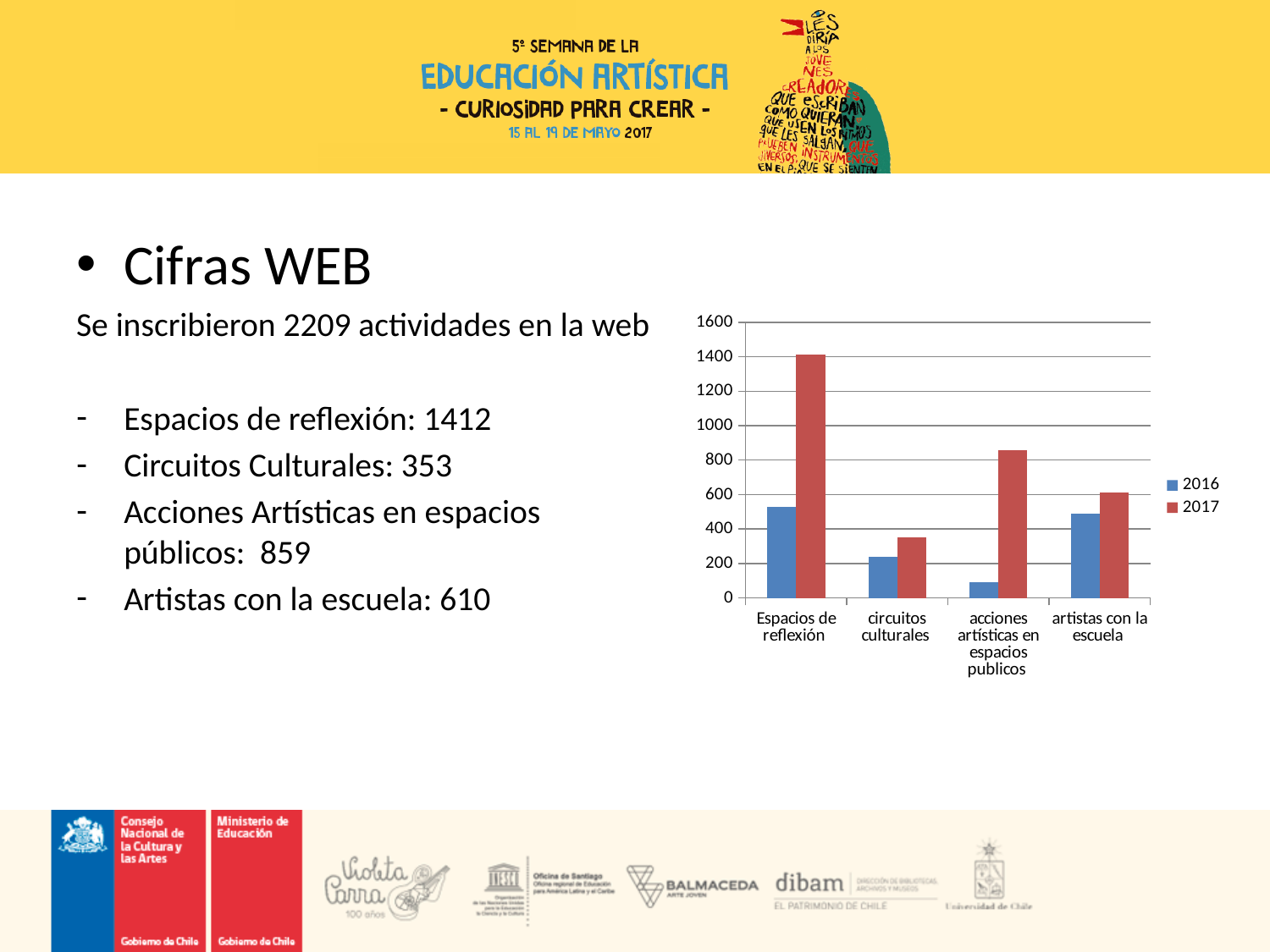
Which category has the highest value for 2017? Espacios de reflexión What colour represents the 2017 series in the chart? red What kind of chart is shown on the slide? bar chart For 2017, which is larger: acciones artísticas en espacios publicos or artistas con la escuela? acciones artísticas en espacios publicos Which category has the lowest value for 2016? acciones artísticas en espacios publicos Is the 2017 value for Espacios de reflexión greater or less than 1200? greater How many series does the chart legend list? 2 How many categories are shown on the x axis of the chart? 4 Is the 2016 value for acciones artísticas en espacios publicos greater or less than 200? less Is the 2017 value for artistas con la escuela greater or less than 400? greater For circuitos culturales, which year has the larger value, 2016 or 2017? 2017 Which category has the lowest value for 2017? circuitos culturales